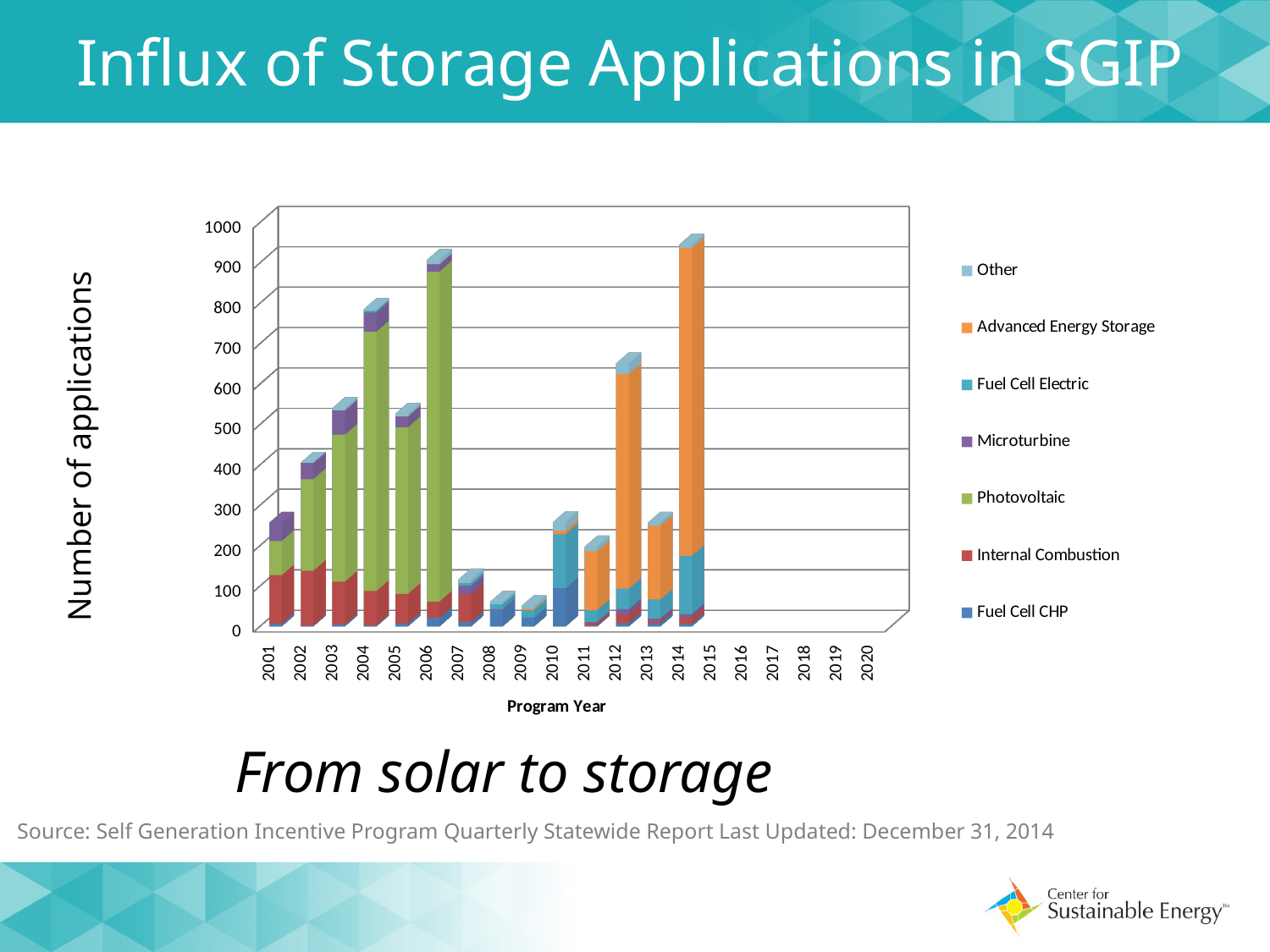
Is the total number of applications for 2012 greater or less than 600? greater Is the total number of applications for 2001 greater or less than 300? less Which program year has the tallest bar? 2014 How many series does the legend list? 7 Do the bar totals rise or fall from 2001 to 2004? rise What kind of chart is shown on the slide? Stacked bar chart Is the total number of applications for 2008 greater or less than 100? less Which bar is taller, 2012 or 2013? 2012 Which bar is taller, 2006 or 2004? 2006 How many program years are labeled on the x axis? 20 What is the title of the x axis? Program Year